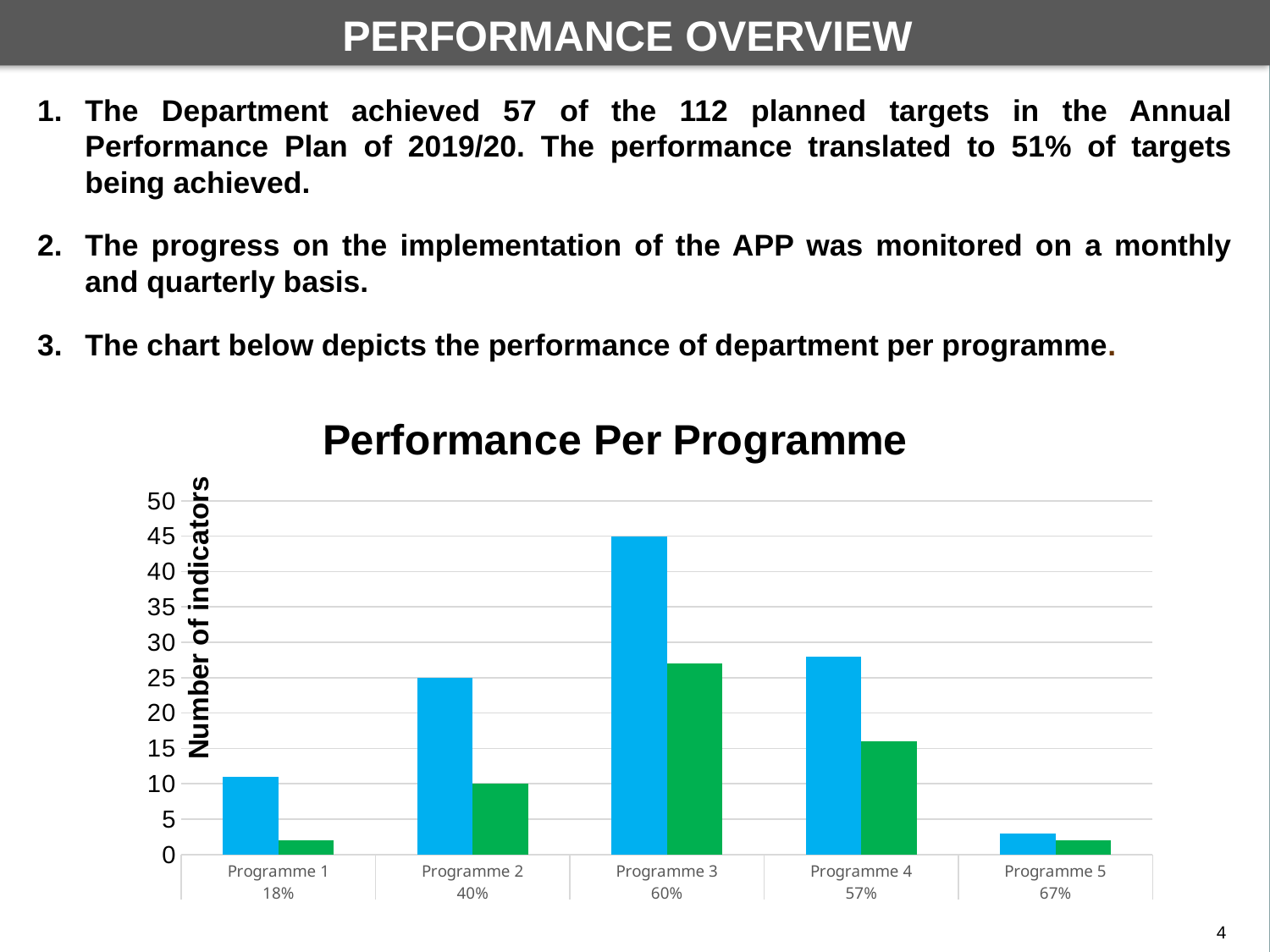
What percentage is printed under Programme 5 on the x axis? 67% Which programme has the shortest green bar? Programme 1 and Programme 5 How many programmes are shown on the x axis of the chart? 5 What is the value of the blue bar for Programme 2? 25 Which programme has the tallest blue bar? Programme 3 What is the value of the blue bar for Programme 3? 45 Is the green bar for Programme 3 greater or less than 25? greater Which is larger, the blue bar for Programme 4 or the blue bar for Programme 2? Programme 4 What is the title of the chart? Performance Per Programme Is the blue bar for Programme 4 greater or less than 30? less What is the label of the vertical axis? Number of indicators What kind of chart is shown on the slide? bar chart